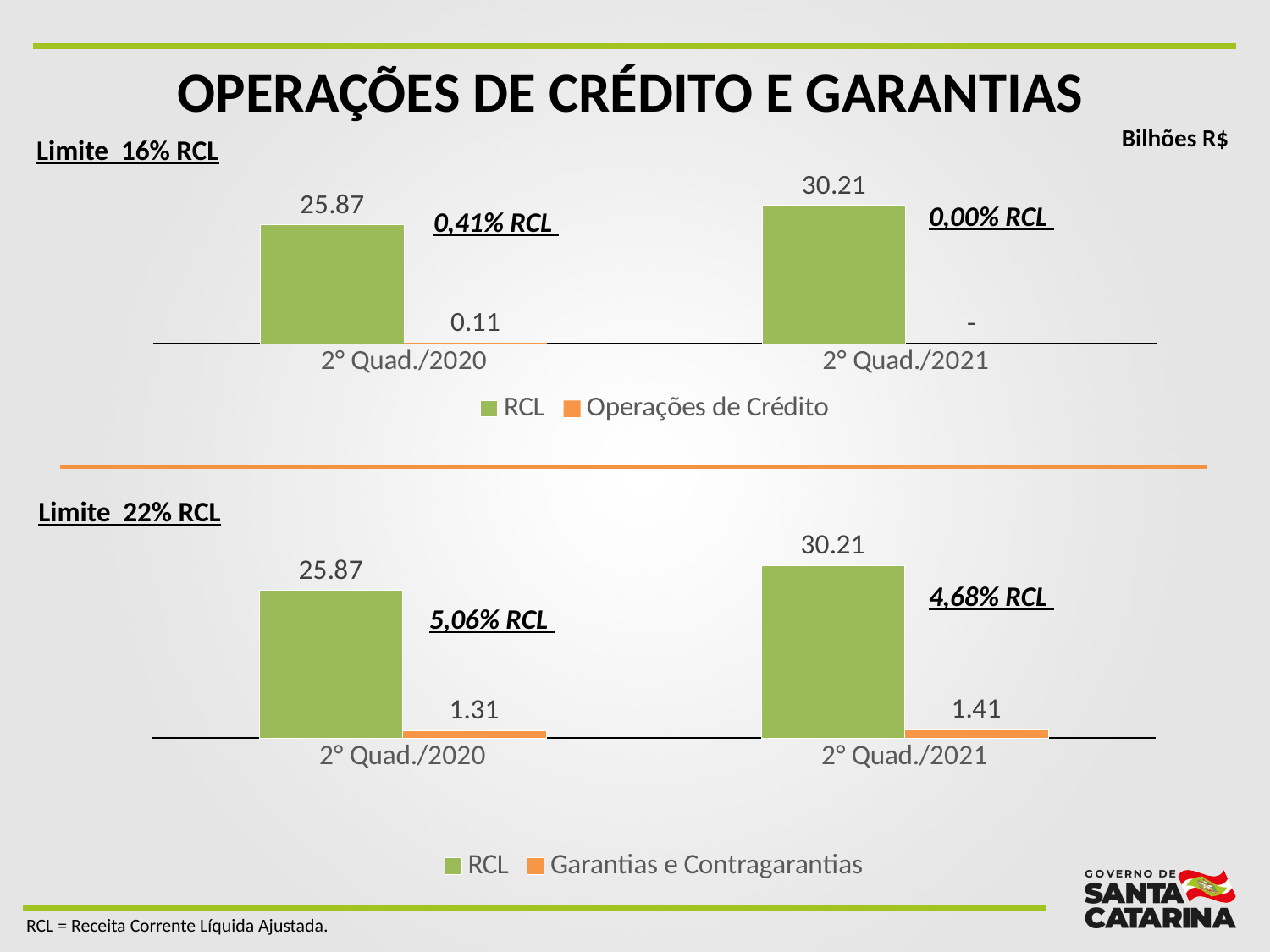
In the bottom chart (Limite 22% RCL), does the Garantias e Contragarantias value rise or fall from 2° Quad./2020 to 2° Quad./2021? Rise In the bottom chart (Limite 22% RCL), which period has the higher Garantias e Contragarantias value? 2° Quad./2021 In the top chart (Limite 16% RCL), what is the RCL value for 2° Quad./2021? 30.21 What type of chart is the top chart (Limite 16% RCL)? Bar chart In the top chart (Limite 16% RCL), what is the RCL value for 2° Quad./2020? 25.87 In the bottom chart (Limite 22% RCL), what is the Garantias e Contragarantias value for 2° Quad./2021? 1.41 How many series does the legend of the bottom chart (Limite 22% RCL) list? 2 In the bottom chart (Limite 22% RCL), what is the Garantias e Contragarantias value for 2° Quad./2020? 1.31 In the bottom chart (Limite 22% RCL), what is the difference between the RCL values for 2° Quad./2021 and 2° Quad./2020? 4.34 How many periods are shown on the x axis of the top chart (Limite 16% RCL)? 2 In the top chart (Limite 16% RCL), what is the Operações de Crédito value for 2° Quad./2020? 0.11 In the top chart (Limite 16% RCL), which is larger: the RCL value for 2° Quad./2020 or for 2° Quad./2021? 2° Quad./2021